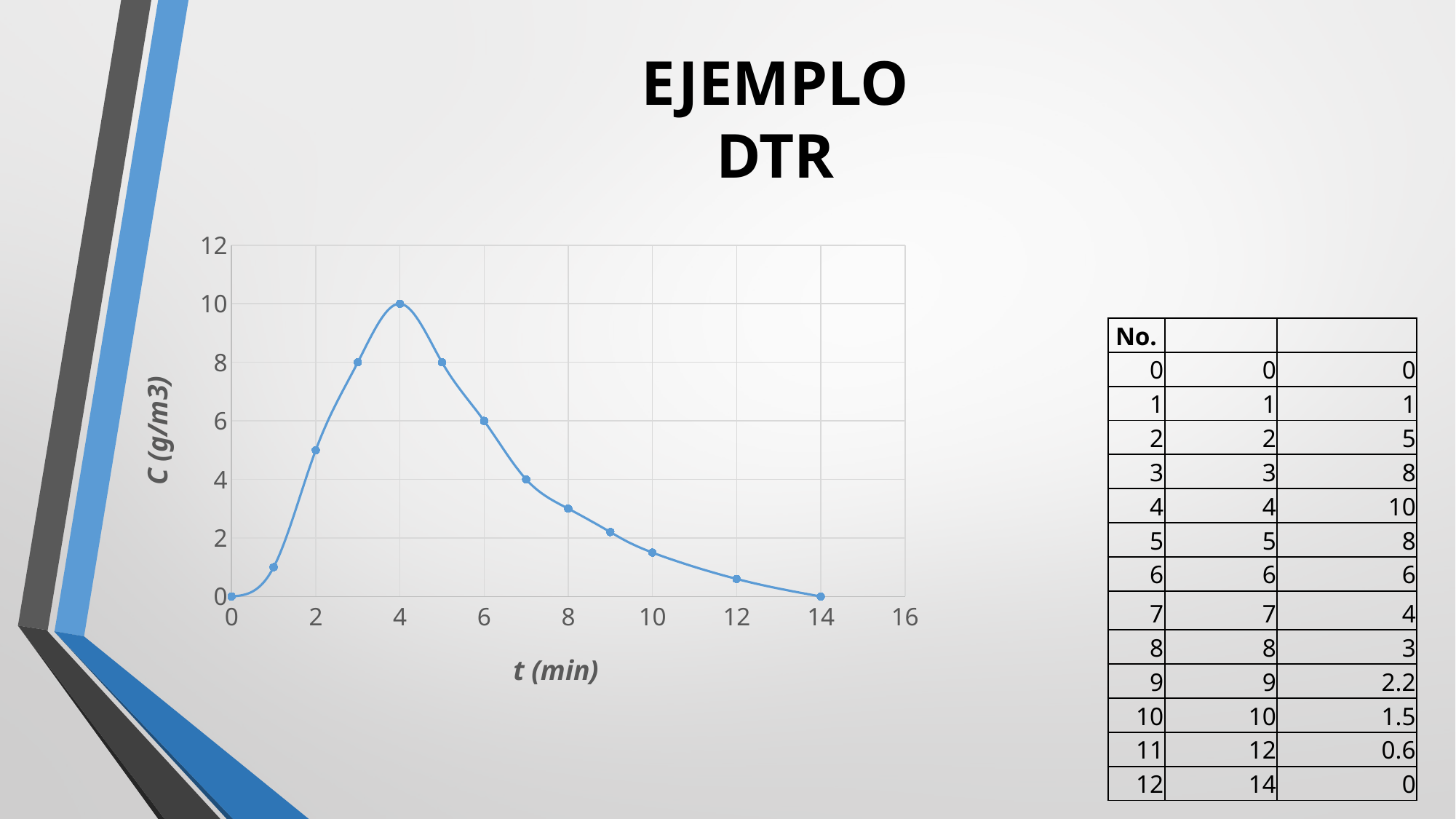
What is the value of C (g/m3) at t = 3 min? 8 Is the value of C at t = 5 min greater or less than 6? greater How many data points are plotted on the chart? 13 What is the label of the x axis of the chart? t (min) Which is larger, C at t = 2 min or C at t = 8 min? t = 2 min What kind of chart is shown on the slide? line chart At which value of t (min) does C (g/m3) reach its highest value? 4 Does C (g/m3) rise or fall as t increases from 4 min to 14 min? fall What is the value of C (g/m3) at t = 4 min? 10 What is the value of C (g/m3) at t = 6 min? 6 What is the value of C (g/m3) at t = 9 min? 2.2 What is the difference between C at t = 4 min and C at t = 7 min? 6